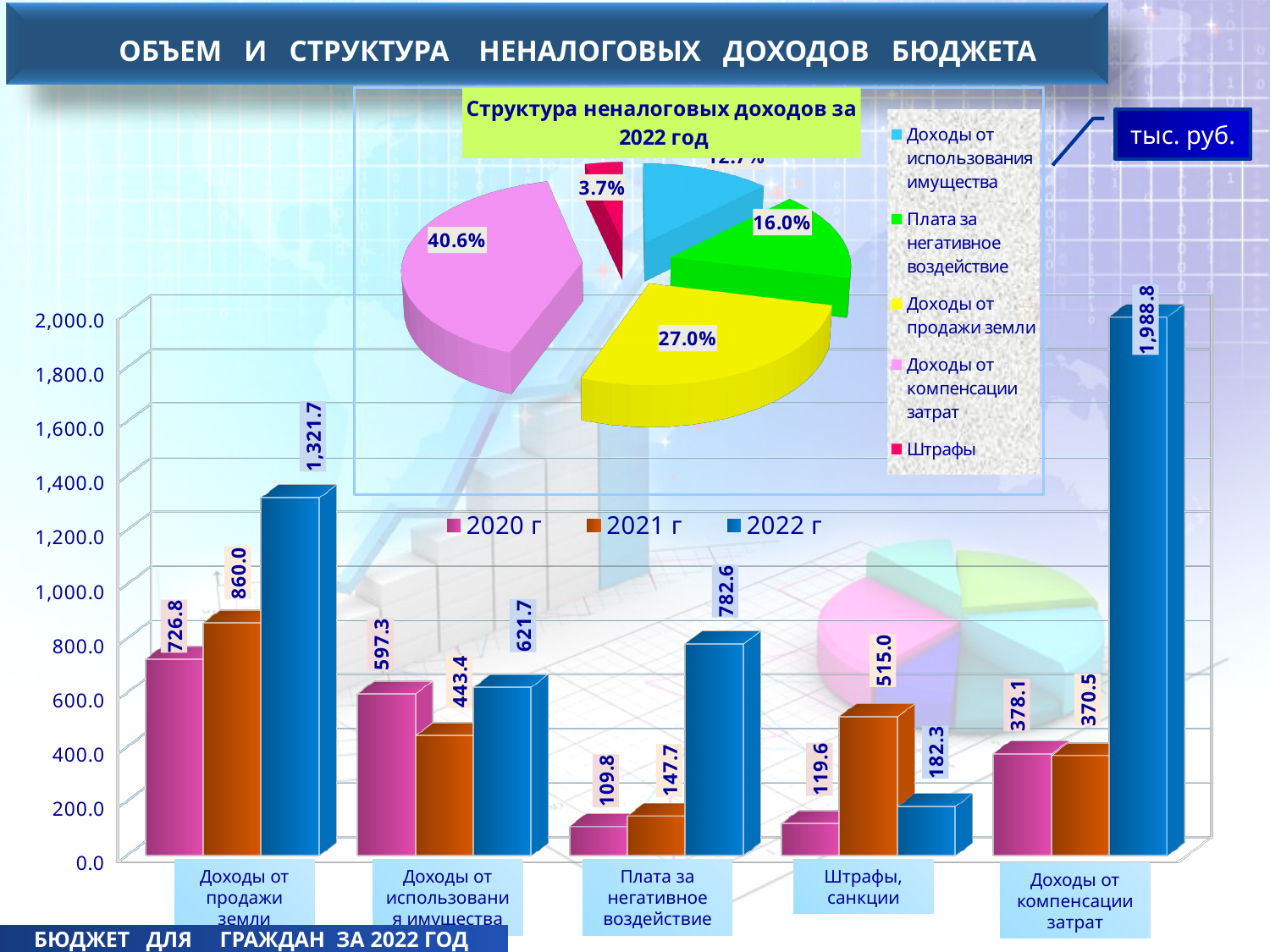
In the bar chart, which category has the lowest value in 2020 г? Плата за негативное воздействие In the bar chart, what is the difference between the 2022 г and 2021 г values for Доходы от компенсации затрат? 1,618.3 In the bar chart, which category has the highest value in 2022 г? Доходы от компенсации затрат In the bar chart, what is the value for Плата за негативное воздействие in 2020 г? 109.8 In the bar chart, what is the value for Доходы от продажи земли in 2022 г? 1,321.7 In the pie chart Структура неналоговых доходов за 2022 год, what share does Доходы от компенсации затрат have? 40.6% In the bar chart, what is the value for Штрафы, санкции in 2021 г? 515.0 What kind of chart is the lower chart on the slide? Bar chart How many series does the legend of the bar chart list? 3 In the bar chart, which is larger for Доходы от использования имущества: the 2020 г value or the 2021 г value? 2020 г How many categories are shown on the x axis of the bar chart? 5 In the pie chart Структура неналоговых доходов за 2022 год, what share does Штрафы have? 3.7%